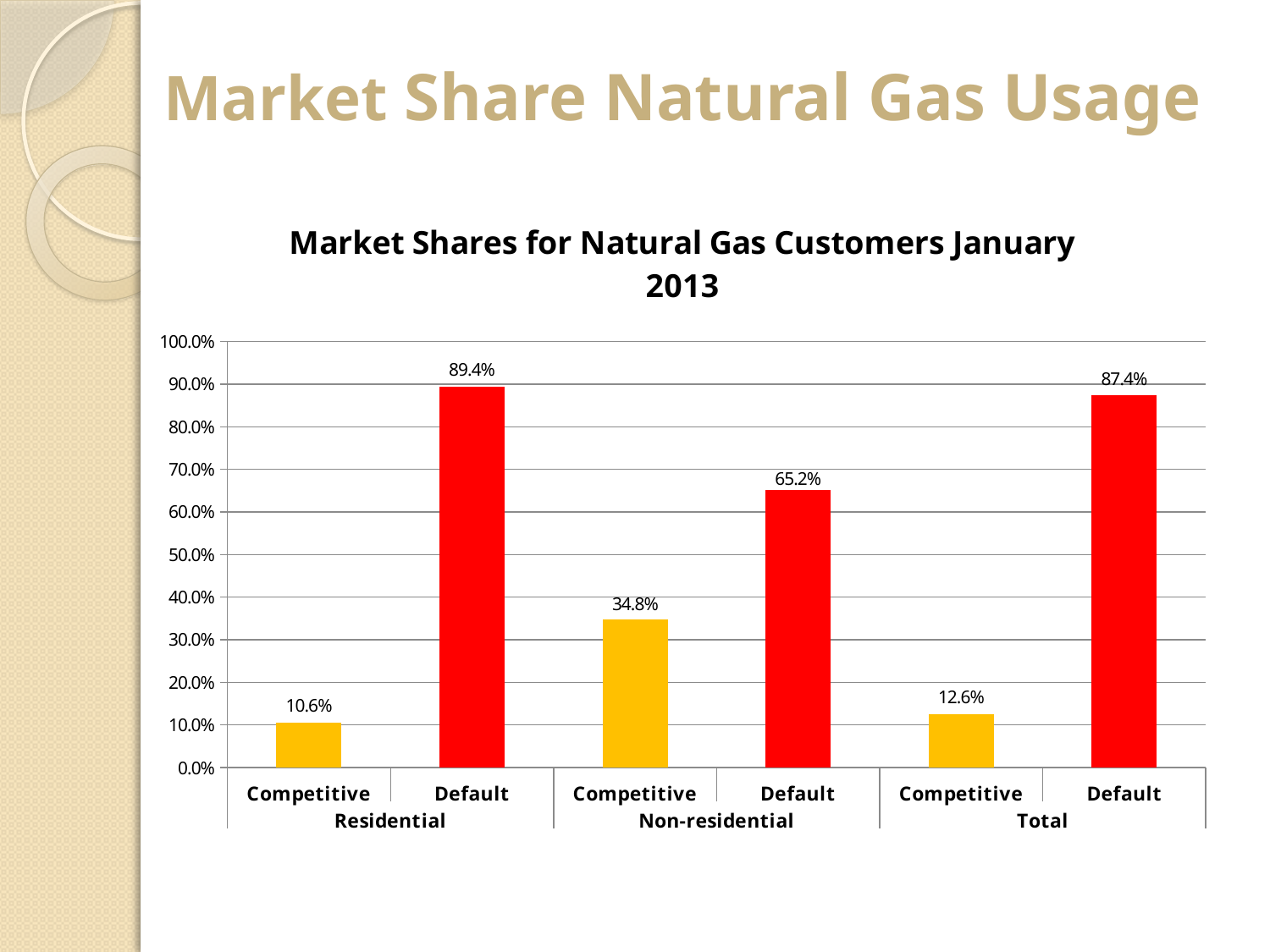
Is the Default share for the Total group greater or less than 80.0%? greater How many bars are plotted on the chart? 6 What is the market share for Competitive customers in the Residential group? 10.6% What type of chart is shown on the slide? Bar chart What is the market share for Competitive customers in the Total group? 12.6% Which bar has the highest value on the chart? Residential Default (89.4%) What is the difference between the Default and Competitive shares in the Non-residential group? 30.4% Which bar has the lowest value on the chart? Residential Competitive (10.6%) What is the market share for Default customers in the Non-residential group? 65.2% What is the difference between the Residential Default share and the Total Default share? 2.0% What is the title of the chart? Market Shares for Natural Gas Customers January 2013 Which is larger, the Competitive share for Non-residential or the Competitive share for Total? Non-residential